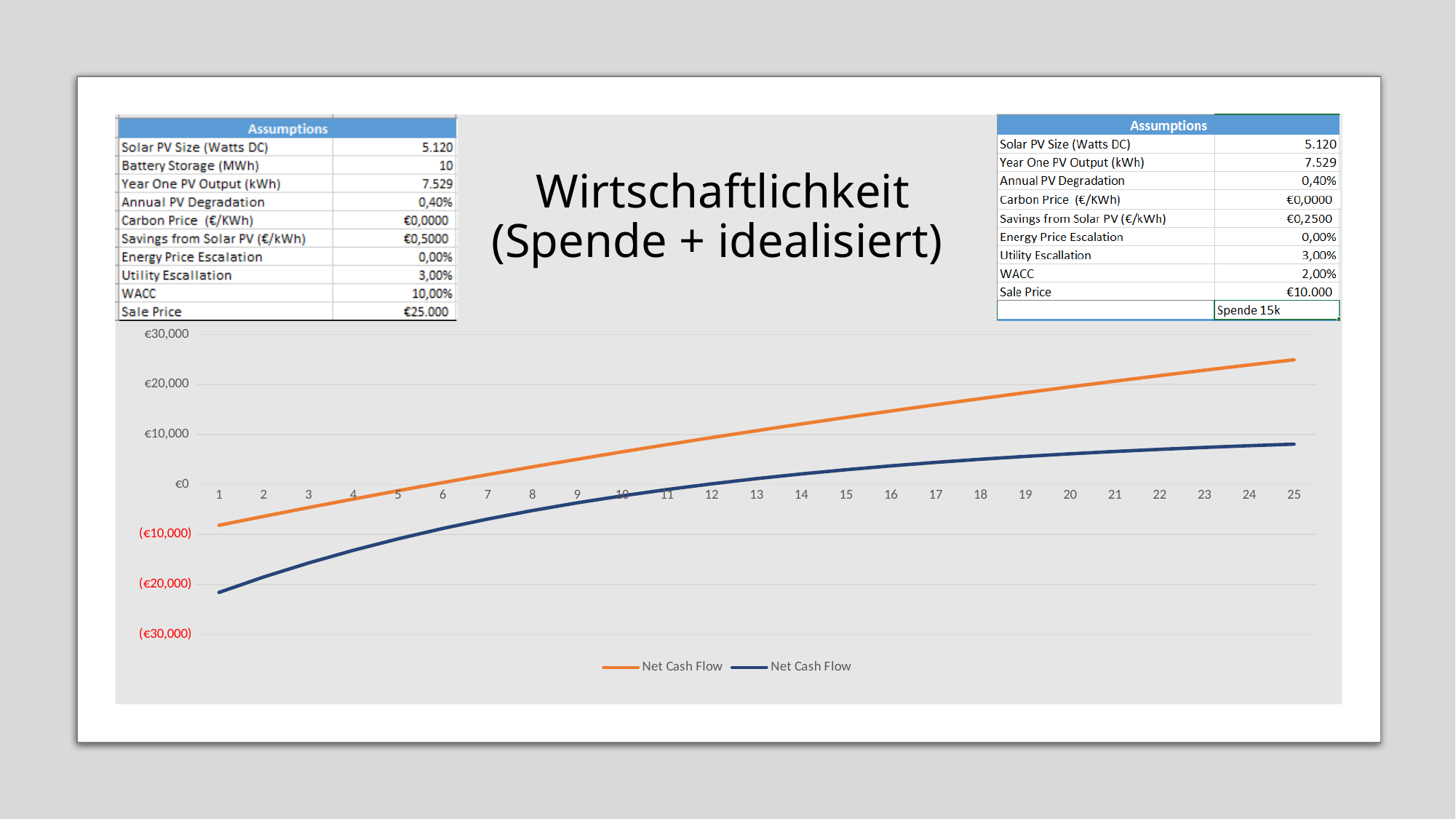
Is the value of the orange line at year 1 greater or less than (€10,000)? greater At year 25, which line has the larger value, the orange line or the blue line? the orange line Is the value of the blue line at year 1 greater or less than (€10,000)? less Is the value of the blue line at year 25 greater or less than €10,000? less What label does the legend give to both series in the chart? Net Cash Flow Do the values of the orange line rise or fall from year 1 to year 25? rise How many series does the chart's legend list? 2 At which year does the orange line reach its highest value? 25 How many points (years) are plotted along the x axis of the chart? 25 Do the values of the blue line rise or fall from year 1 to year 25? rise What kind of chart is shown on the slide? line chart